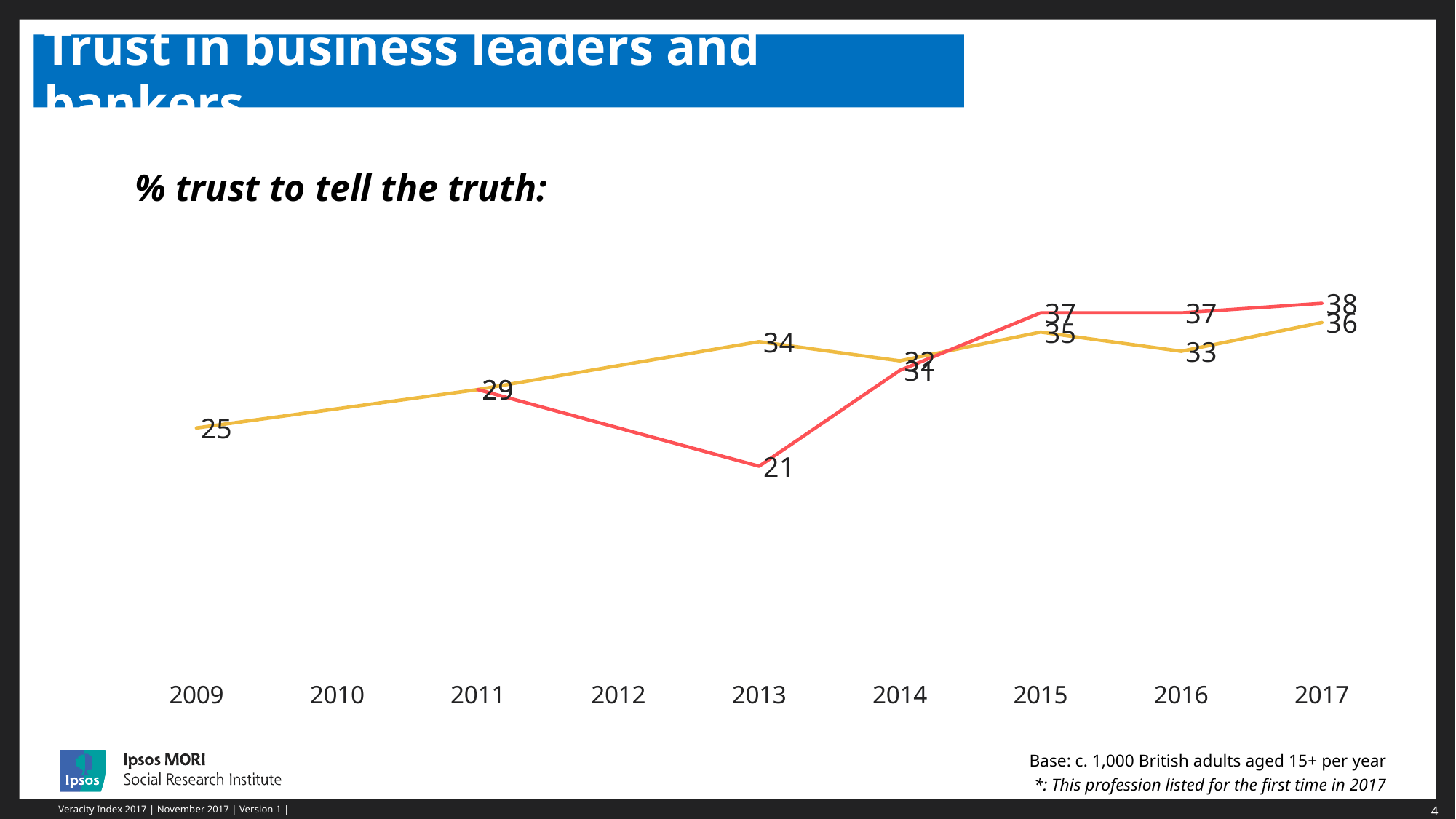
In which year does the red line reach its lowest value? 2013 Which line has the higher value in 2016, the red line or the yellow line? red line What is the value of the red line in 2013? 21 What is the difference between the red line and the yellow line in 2013? 13 What kind of chart is shown on the slide? line chart Does the red line rise or fall between 2013 and 2015? rise In which year does the yellow line reach its highest value? 2017 What is the value of the yellow line in 2009? 25 How many years are labelled on the x axis? 9 What is the value of the red line in 2017? 38 What is the value of the yellow line in 2016? 33 What is the value of the yellow line in 2013? 34